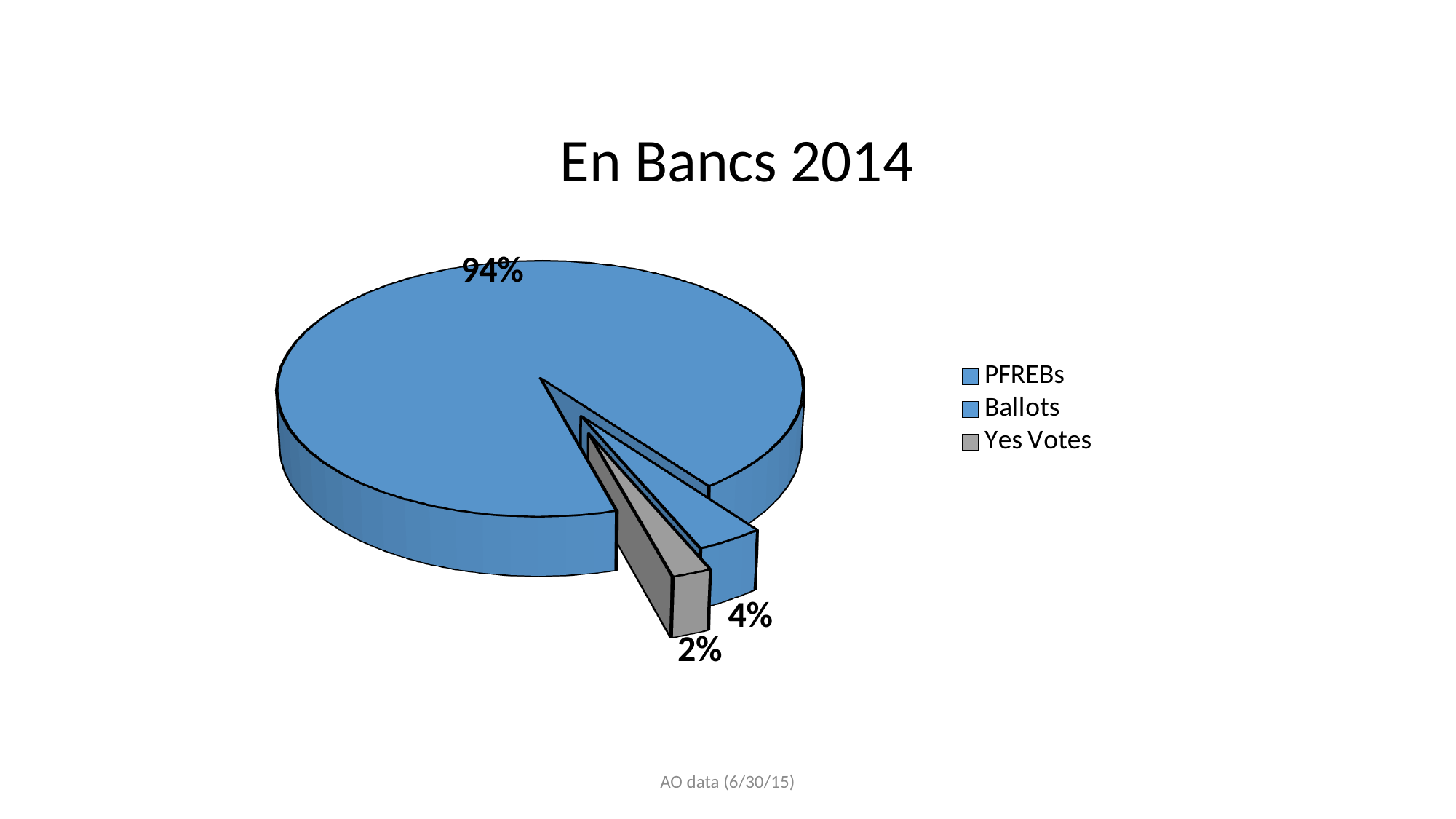
How many slices does the pie chart have? 3 What share of the pie does the Ballots slice represent? 4% What is the title of the chart? En Bancs 2014 What is the difference in percentage points between the 4% slice and the 2% slice? 2% What colour is the Yes Votes slice in the legend? gray Which legend entry corresponds to the largest slice of the pie? PFREBs What share of the pie does the PFREBs slice represent? 94% What kind of chart is shown on the slide? pie chart What share of the pie does the largest slice represent? 94% Which legend entry corresponds to the smallest slice of the pie? Yes Votes How many entries does the legend list? 3